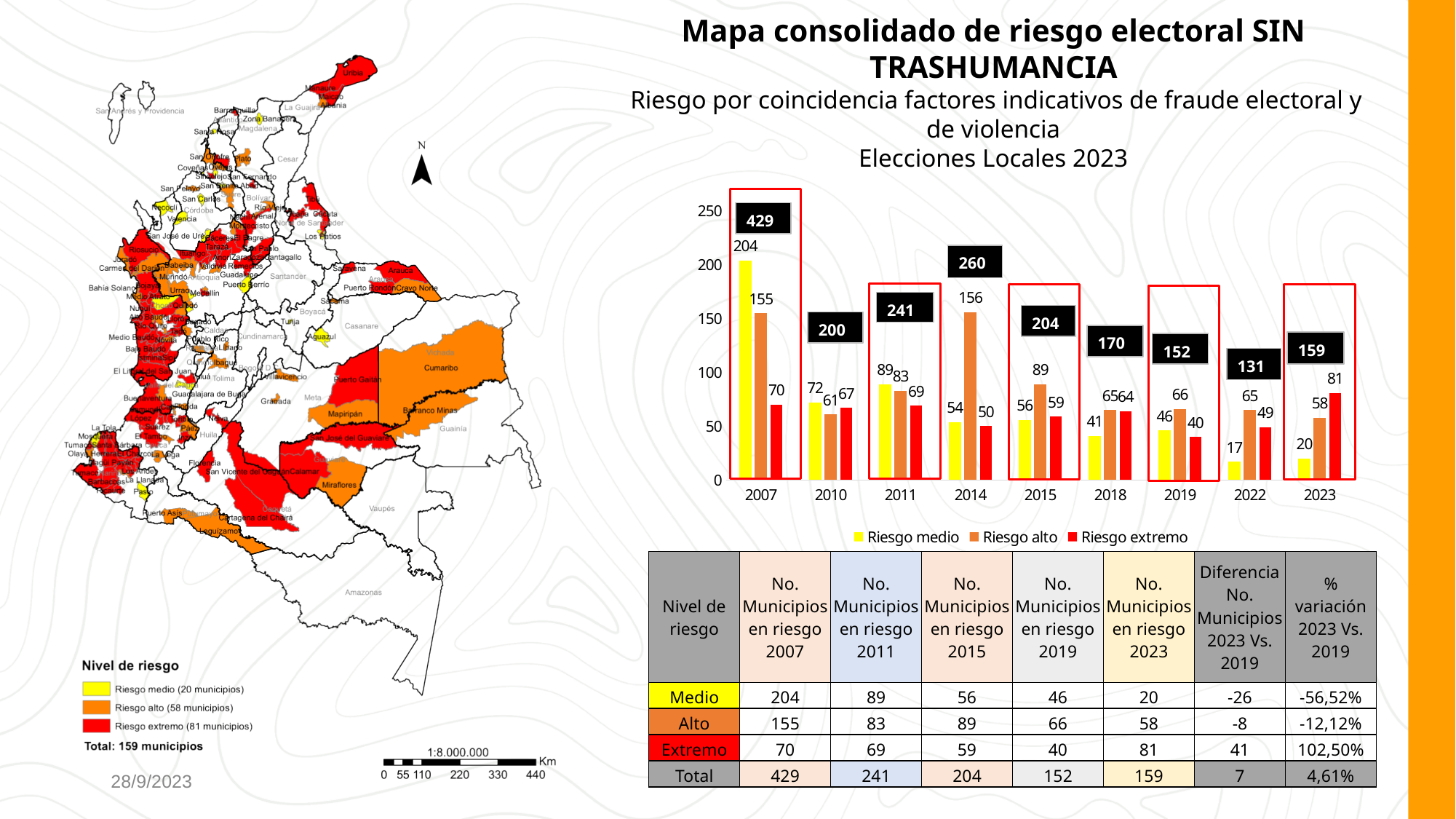
Does Riesgo medio rise or fall from 2007 to 2023? fall What kind of chart is shown on the slide? bar chart What is the value of Riesgo extremo in 2023? 81 What total is shown in the black box above the 2011 bars? 241 In which year is Riesgo alto highest? 2014 In which year is Riesgo medio lowest? 2022 How many years are shown on the x axis of the chart? 9 Which is larger in 2015: Riesgo alto or Riesgo extremo? Riesgo alto What is the difference between Riesgo extremo in 2023 and Riesgo extremo in 2019? 41 What is the value of Riesgo alto in 2014? 156 What is the value of Riesgo medio in 2007? 204 How many series does the chart legend list? 3